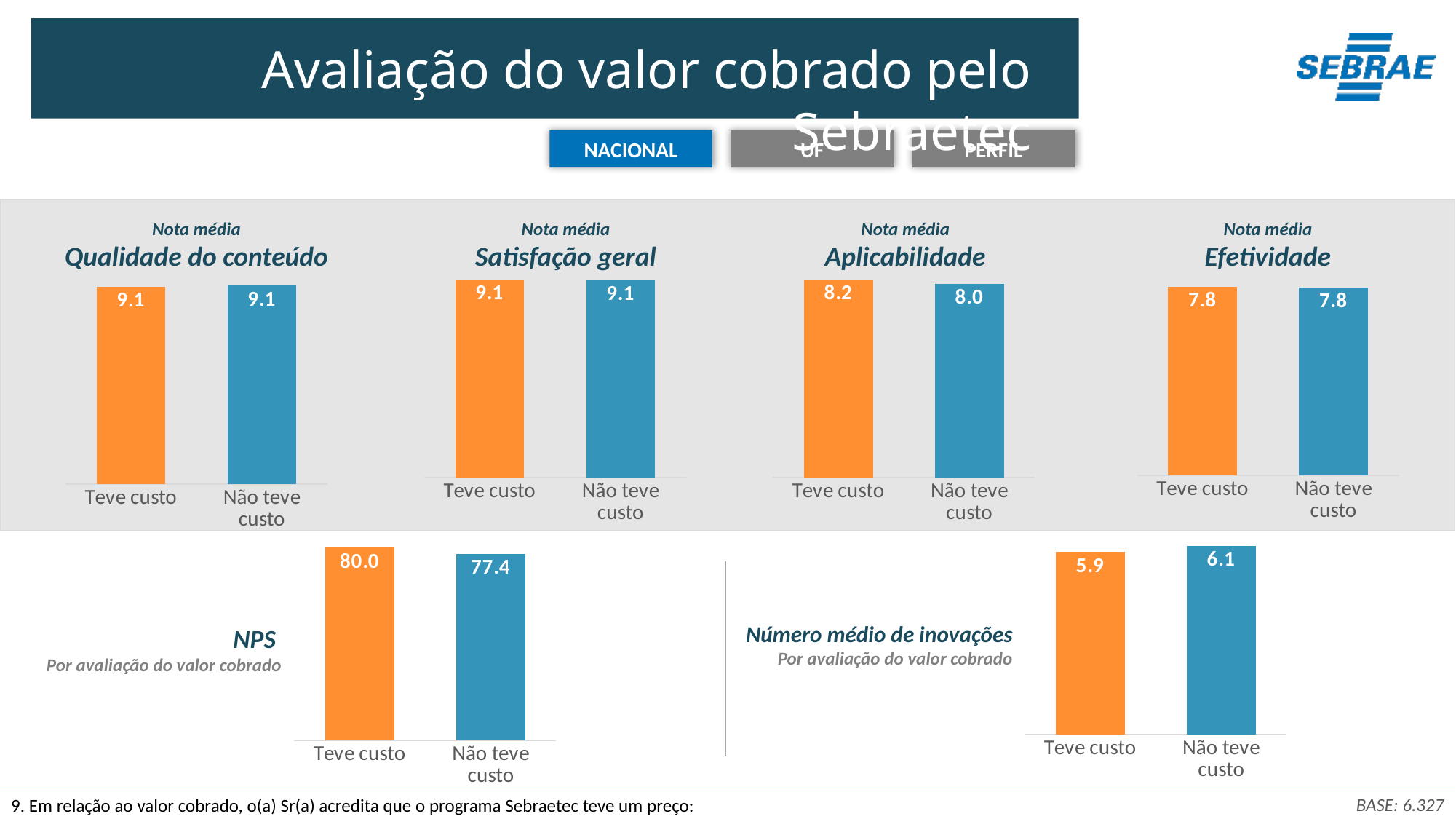
In the 'Número médio de inovações' chart, which category has the higher value? Não teve custo In the 'NPS' chart, what is the value for 'Não teve custo'? 77.4 In the 'Número médio de inovações' chart, what is the value for 'Teve custo'? 5.9 In the 'Aplicabilidade' chart, what is the value for 'Teve custo'? 8.2 In the 'Satisfação geral' chart, what is the value for 'Não teve custo'? 9.1 In the 'Aplicabilidade' chart, what is the difference between 'Teve custo' and 'Não teve custo'? 0.2 What type of chart is the 'Efetividade' chart? Bar chart In the 'NPS' chart, what is the difference between 'Teve custo' and 'Não teve custo'? 2.6 In the 'NPS' chart, what is the value for 'Teve custo'? 80.0 How many categories are shown in the 'NPS' chart? 2 In the 'Efetividade' chart, what is the value for 'Não teve custo'? 7.8 In the 'Qualidade do conteúdo' chart, what is the value for 'Teve custo'? 9.1